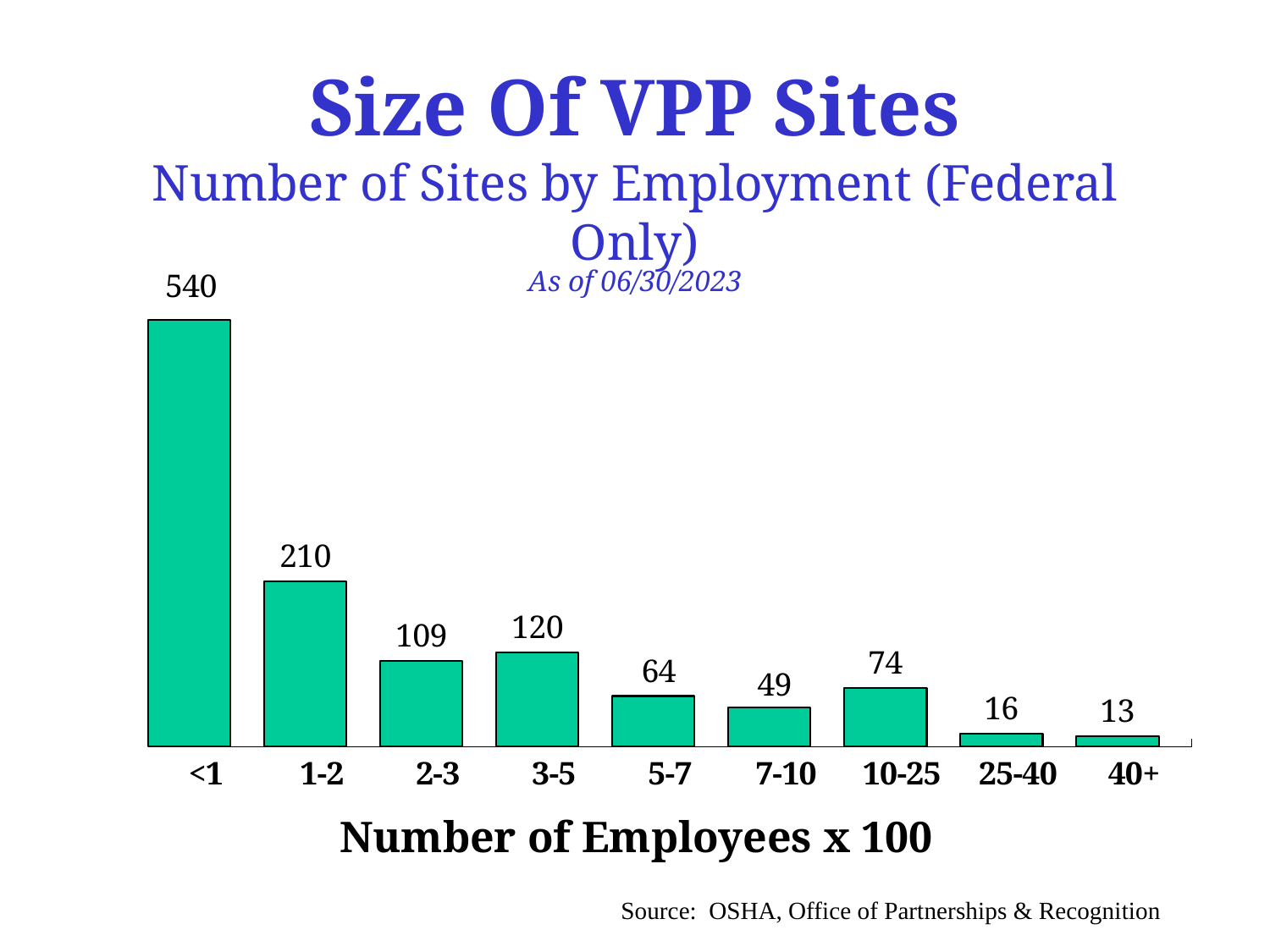
What kind of chart is shown on the slide? Bar chart Which category has the highest number of sites? <1 Which has more sites, the 5-7 category or the 7-10 category? 5-7 What is the x-axis title of the chart? Number of Employees x 100 What is the difference between the 3-5 and 2-3 categories? 11 Which is larger, the value for 3-5 or the value for 10-25? 3-5 What is the value for the 40+ category? 13 How many categories are shown on the x axis? 9 Which category has the lowest number of sites? 40+ What is the difference between the <1 and 1-2 categories? 330 How many sites are in the <1 category? 540 What is the number of sites for the 10-25 category? 74